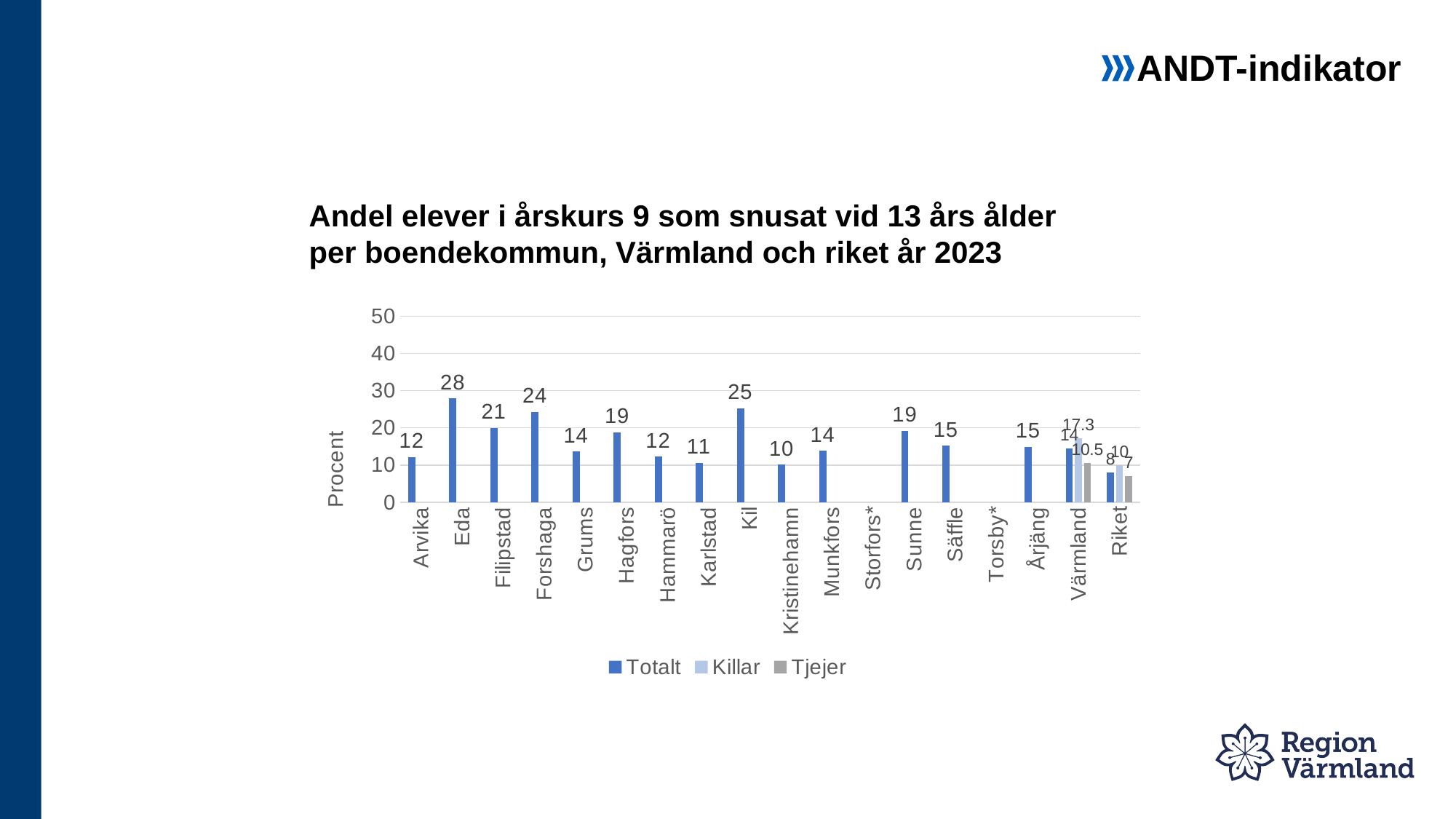
What is the Tjejer value for Riket? 7 Which has a higher Totalt value, Forshaga or Filipstad? Forshaga Which category has the highest Totalt value? Eda What is the Totalt value for Eda? 28 What is the Killar value for Värmland? 17.3 What is the label on the y axis? Procent Which category has the lowest Totalt value shown? Riket What is the difference between the Totalt values for Kil and Karlstad? 14 How many series does the legend list? 3 How many categories are shown on the x axis? 18 What is the difference between the Killar and Tjejer values for Värmland? 6.8 What kind of chart is shown on the slide? Bar chart